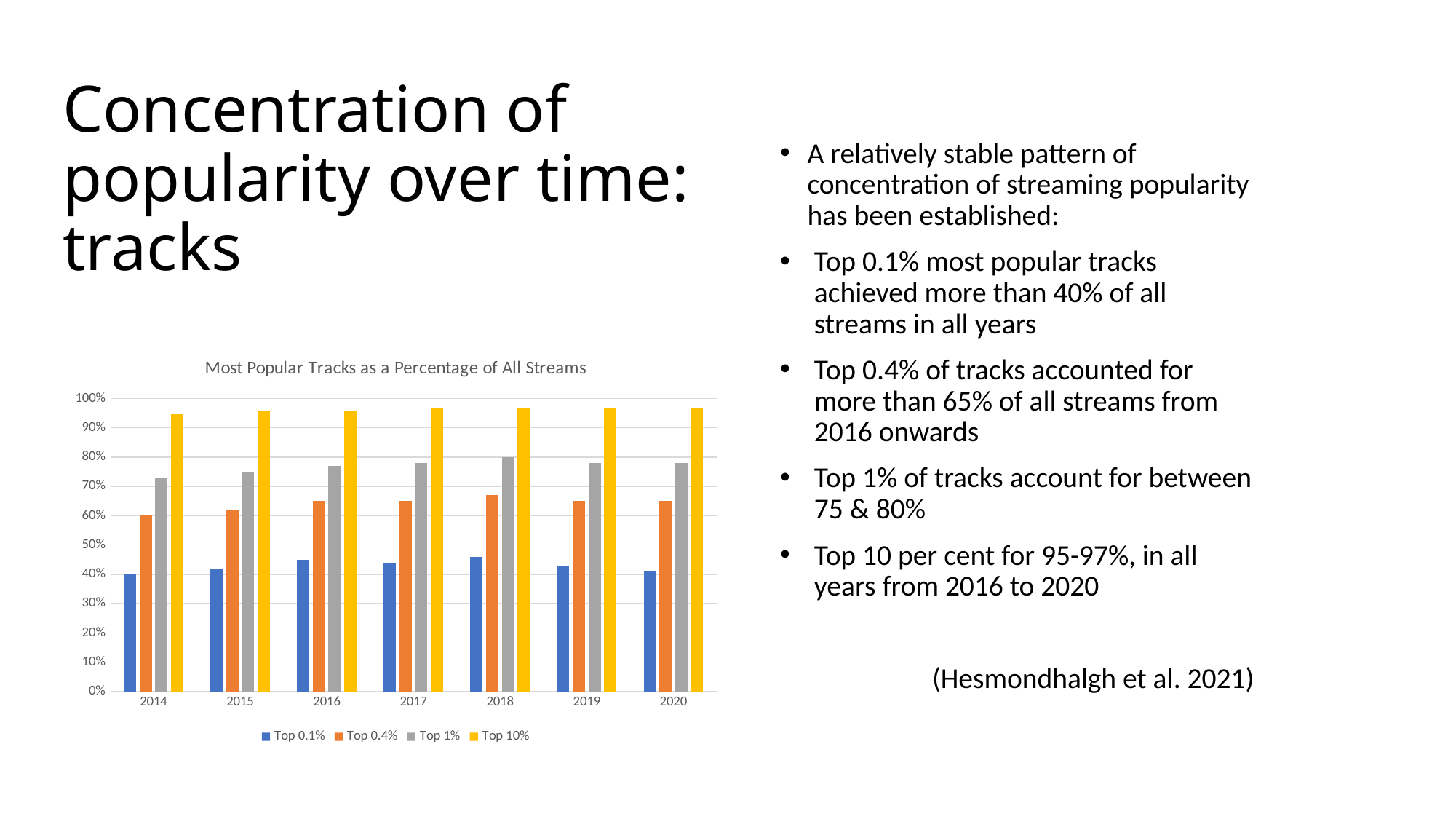
Is the value for Top 10% in 2014 greater or less than 90%? greater Is the value for Top 0.4% in 2015 greater or less than 70%? less Which series has the lowest value in 2018? Top 0.1% Which series has the highest value in 2014? Top 10% What kind of chart is shown on the slide? bar chart Is the value for Top 0.1% in 2016 greater or less than 40%? greater In 2014, which is larger: the value for Top 1% or the value for Top 0.4%? Top 1% How many years are shown on the x axis of the chart? 7 What is the title of the chart? Most Popular Tracks as a Percentage of All Streams How many series does the chart legend list? 4 Does the value for Top 0.4% rise or fall from 2014 to 2016? rise